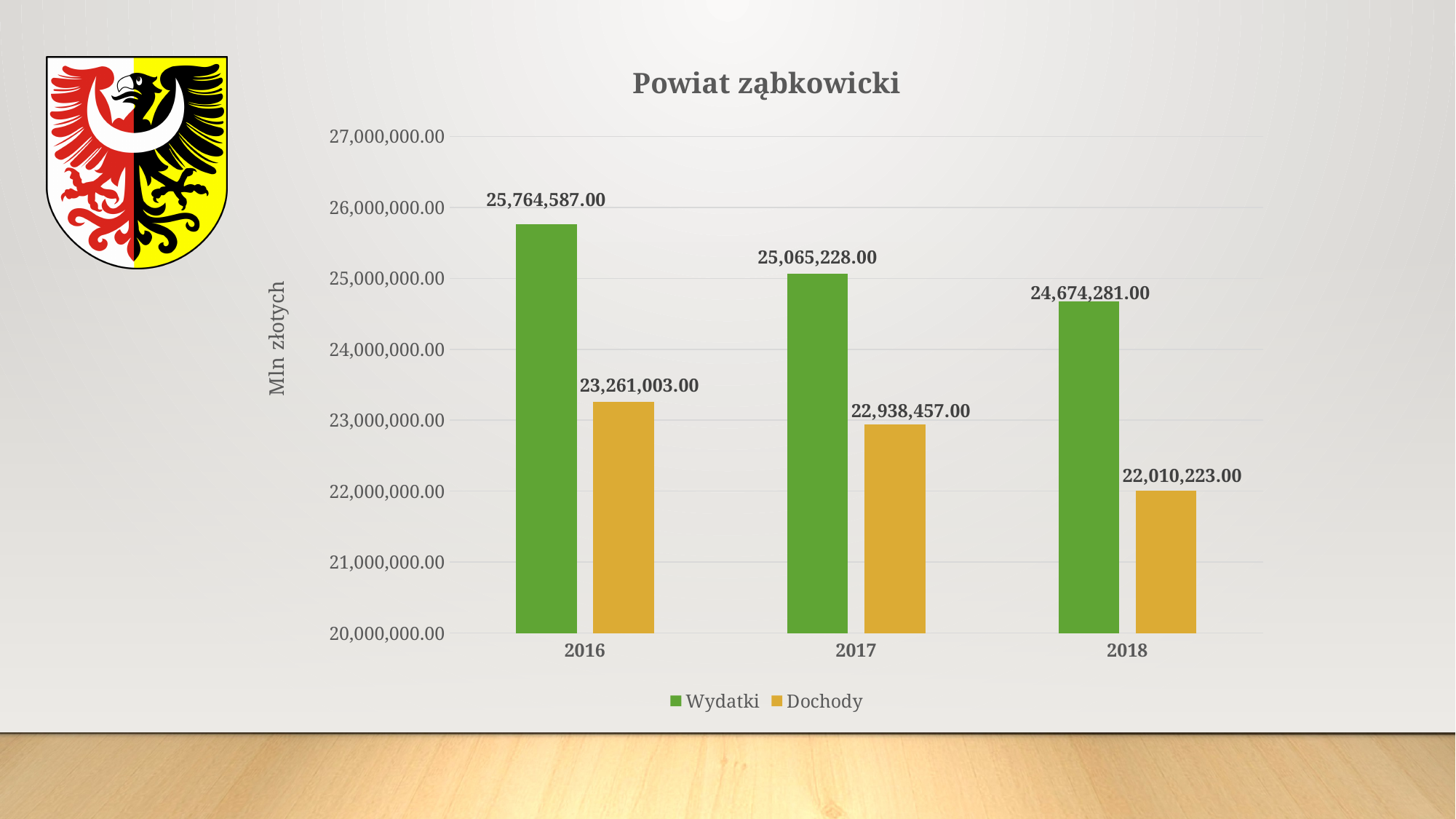
Do the Dochody values rise or fall from 2016 to 2018? fall In which year is Wydatki highest? 2016 By how much did Wydatki decrease from 2016 to 2018? 1,090,306.00 How many series does the legend list? 2 What is the difference between Wydatki and Dochody in 2018? 2,664,058.00 What is the value of Wydatki for 2016? 25,764,587.00 In which year is Dochody lowest? 2018 How many years are shown on the x axis? 3 What is the value of Dochody for 2018? 22,010,223.00 What kind of chart is shown? bar chart What is the value of Dochody for 2017? 22,938,457.00 Which is larger in 2017, Wydatki or Dochody? Wydatki